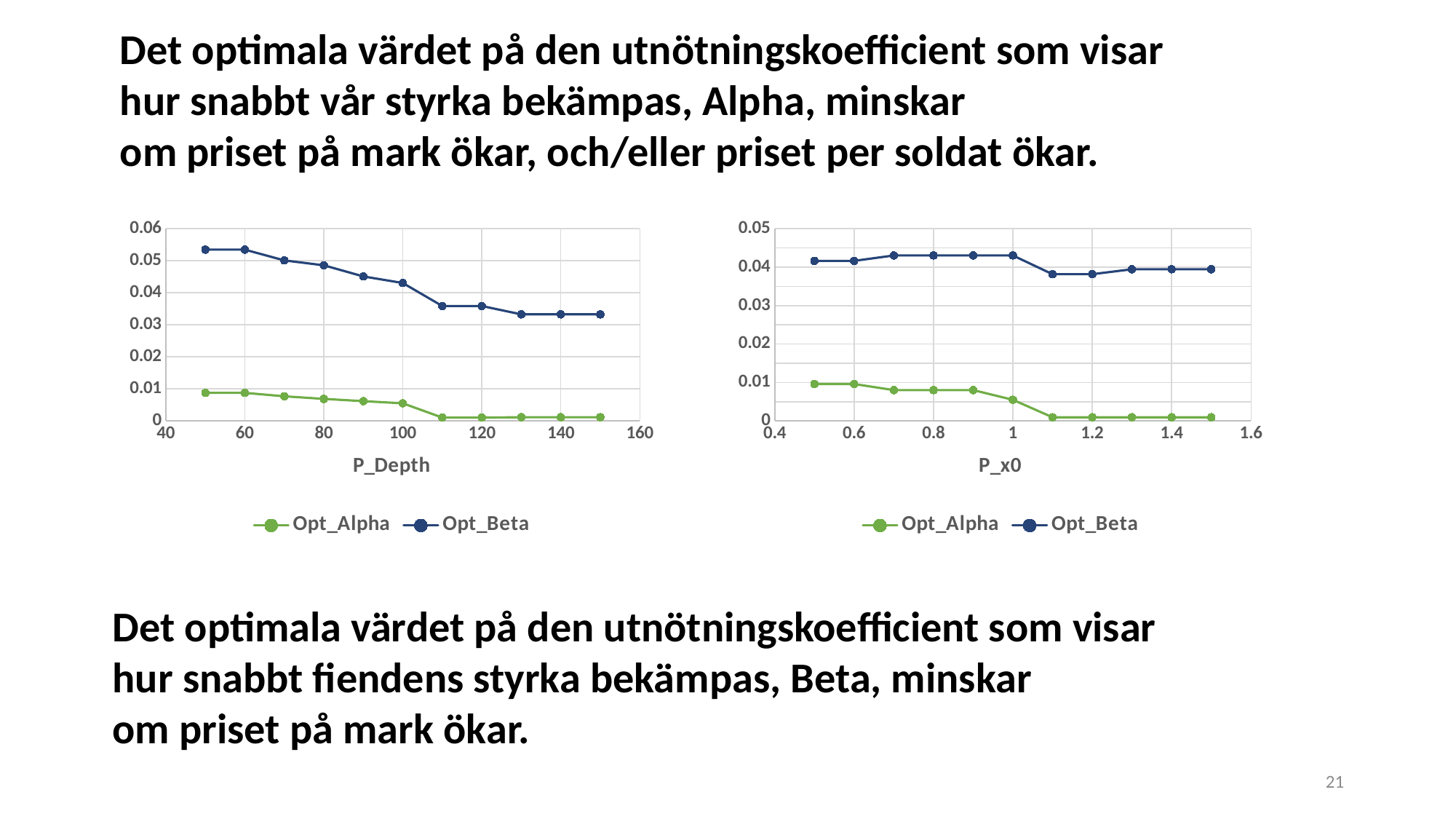
What colour is the Opt_Alpha line in the left chart? green What kind of chart is the left chart with x-axis P_Depth? line chart In the right chart (P_x0), is the Opt_Beta value at P_x0 0.8 greater or less than 0.04? greater How many series does the legend of the right chart (P_x0) list? 2 In the left chart (P_Depth), does Opt_Beta rise or fall as P_Depth increases? fall In the left chart (P_Depth), how many data points does the Opt_Beta series have? 11 In the left chart (P_Depth), is the Opt_Beta value at P_Depth 50 greater or less than 0.05? greater What is the x-axis title of the right chart? P_x0 In the right chart (P_x0), which series has the higher values, Opt_Alpha or Opt_Beta? Opt_Beta In the right chart (P_x0), is the Opt_Beta value at P_x0 1.2 greater or less than 0.04? less